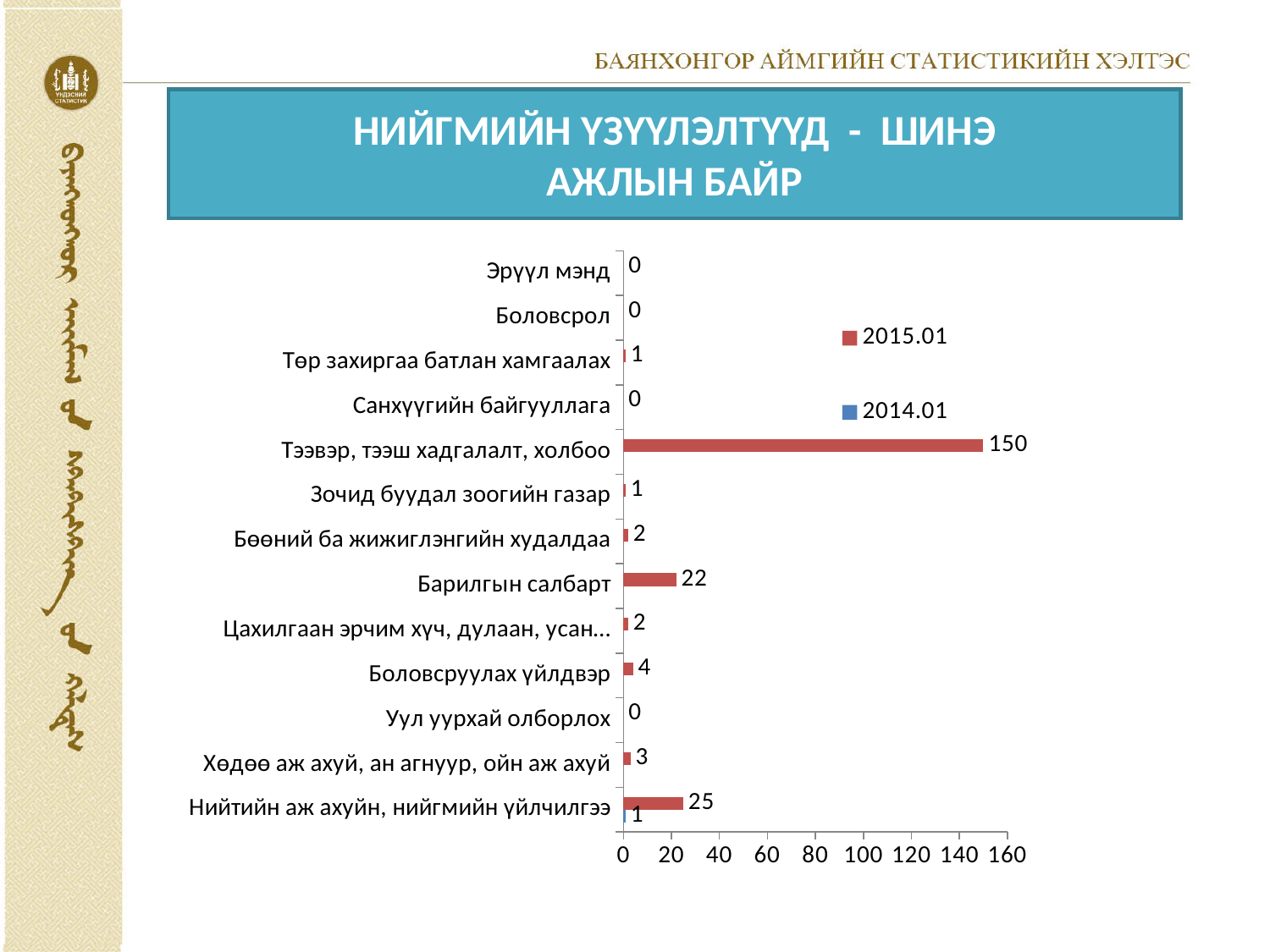
What is the 2015.01 value for Хөдөө аж ахуй, ан агнуур, ойн аж ахуй? 3 How many series does the legend list? 2 What is the 2015.01 value for Нийтийн аж ахуйн, нийгмийн үйлчилгээ? 25 How many categories are shown on the chart? 13 Which has the larger 2015.01 value, Барилгын салбарт or Боловсруулах үйлдвэр? Барилгын салбарт What type of chart is shown on the slide? bar chart What is the 2015.01 value for Тээвэр, тээш хадгалалт, холбоо? 150 What is the difference between the 2015.01 values for Тээвэр, тээш хадгалалт, холбоо and Нийтийн аж ахуйн, нийгмийн үйлчилгээ? 125 What is the 2014.01 value for Нийтийн аж ахуйн, нийгмийн үйлчилгээ? 1 What is the 2015.01 value for Барилгын салбарт? 22 Which category has the highest 2015.01 value? Тээвэр, тээш хадгалалт, холбоо Which series is shown in red in the legend? 2015.01